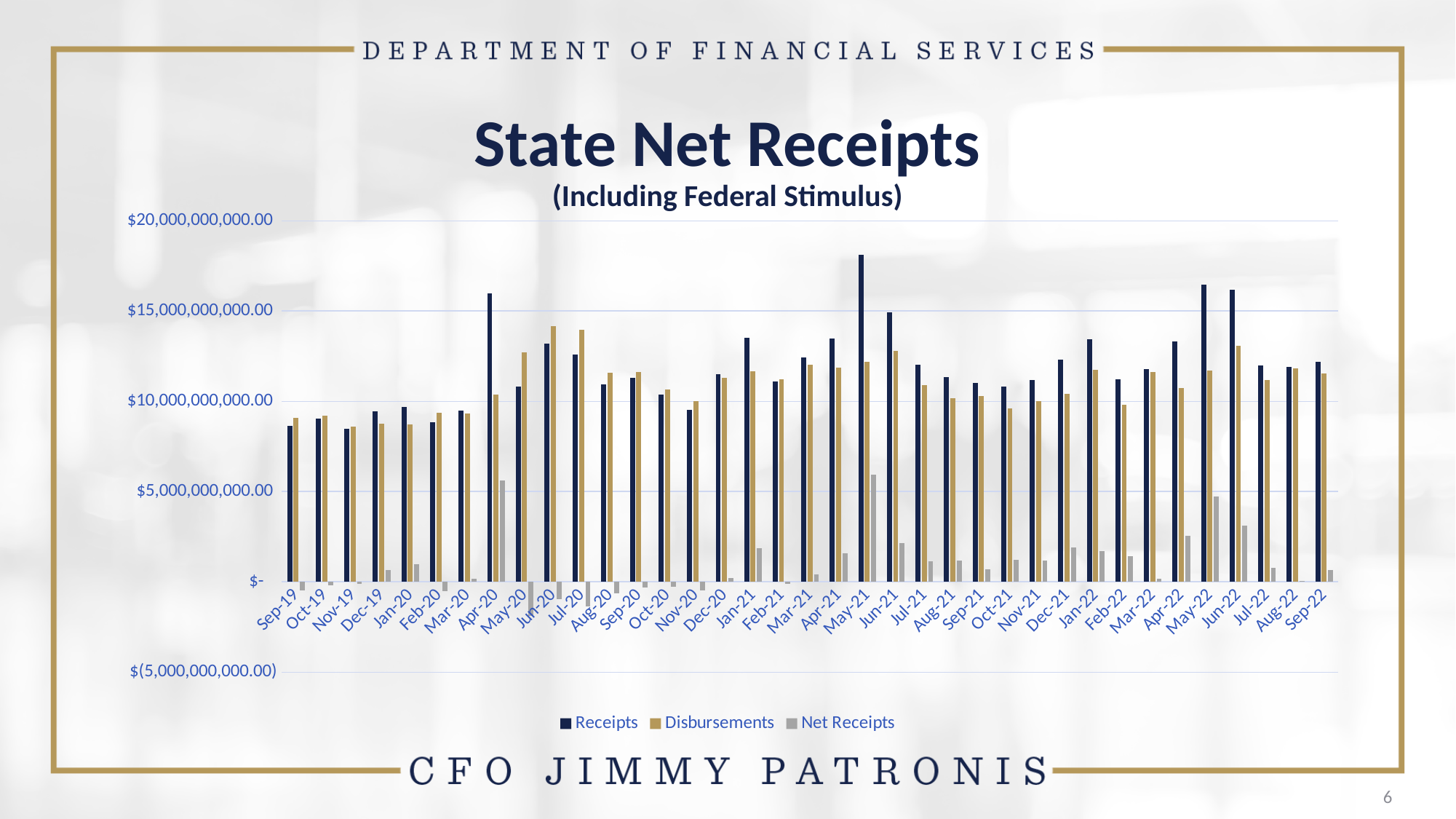
How many months are shown along the x axis? 37 Is the Receipts value for May-21 greater or less than $15,000,000,000.00? greater How many series does the legend list? 3 In Jun-20, which is larger: Receipts or Disbursements? Disbursements Is the Receipts value for May-22 greater or less than $15,000,000,000.00? greater In May-21, which is larger: Receipts or Disbursements? Receipts What is the subtitle shown under the chart title 'State Net Receipts'? (Including Federal Stimulus) Which month has the highest Receipts value? May-21 Is the Receipts value for Sep-19 greater or less than $10,000,000,000.00? less What kind of chart is shown on the slide? Bar chart